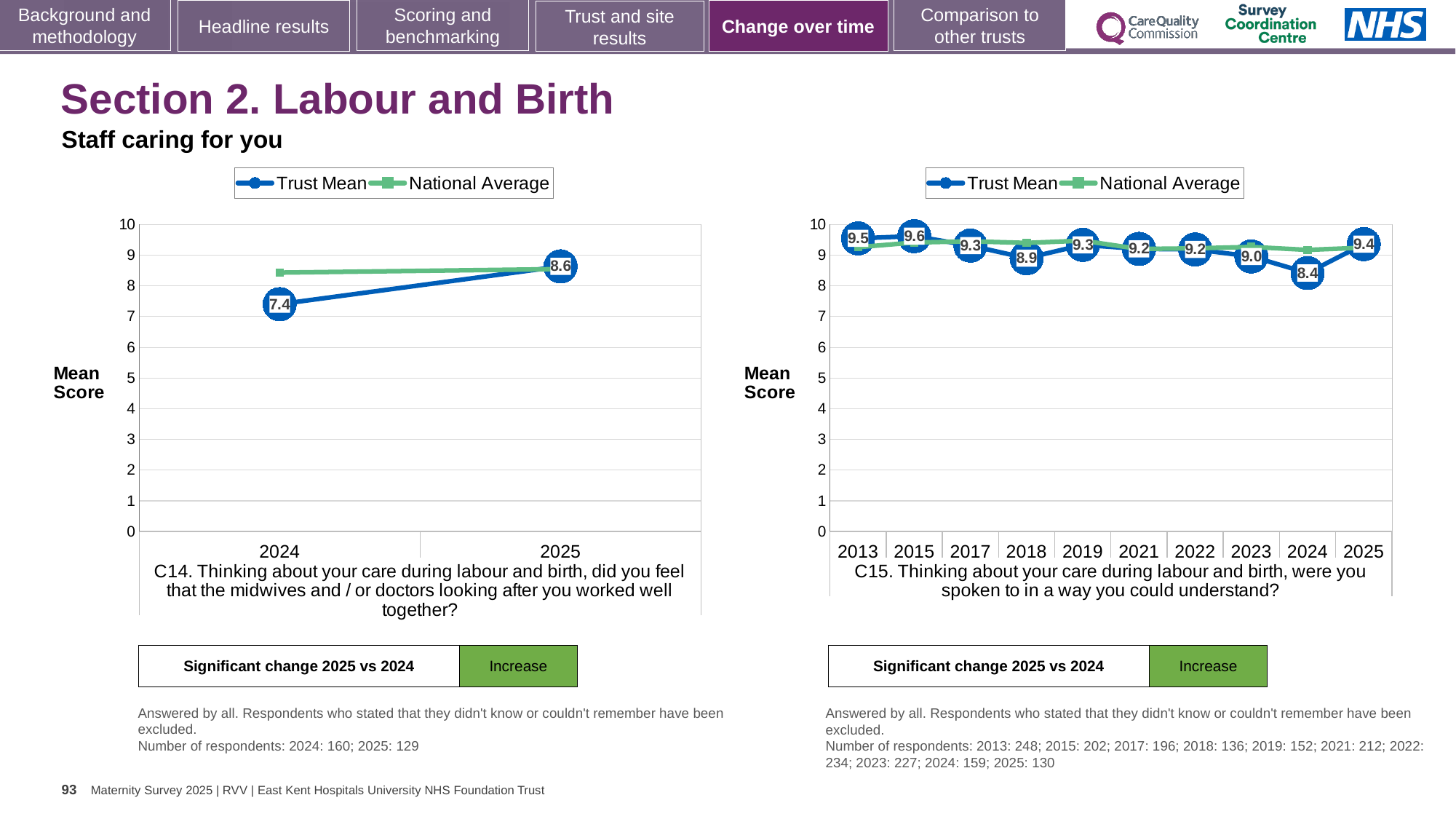
In the right chart (C15), how many years are shown on the x axis? 10 In the left chart (C14), what is the Trust Mean value for 2024? 7.4 In the right chart (C15), what is the difference between the Trust Mean in 2025 and in 2024? 1.0 In the left chart (C14), what is the Trust Mean value for 2025? 8.6 In the right chart (C15), what is the Trust Mean value for 2024? 8.4 In the left chart (C14), is the National Average value for 2024 greater or less than 8? greater In the right chart (C15), what is the Trust Mean value for 2018? 8.9 In the left chart (C14), does the Trust Mean rise or fall from 2024 to 2025? rise In the left chart (C14), by how much did the Trust Mean change from 2024 to 2025? 1.2 How many series does the legend of the left chart (C14) list? 2 In the right chart (C15), which year has the highest Trust Mean? 2015 In the right chart (C15), which year has the lowest Trust Mean? 2024